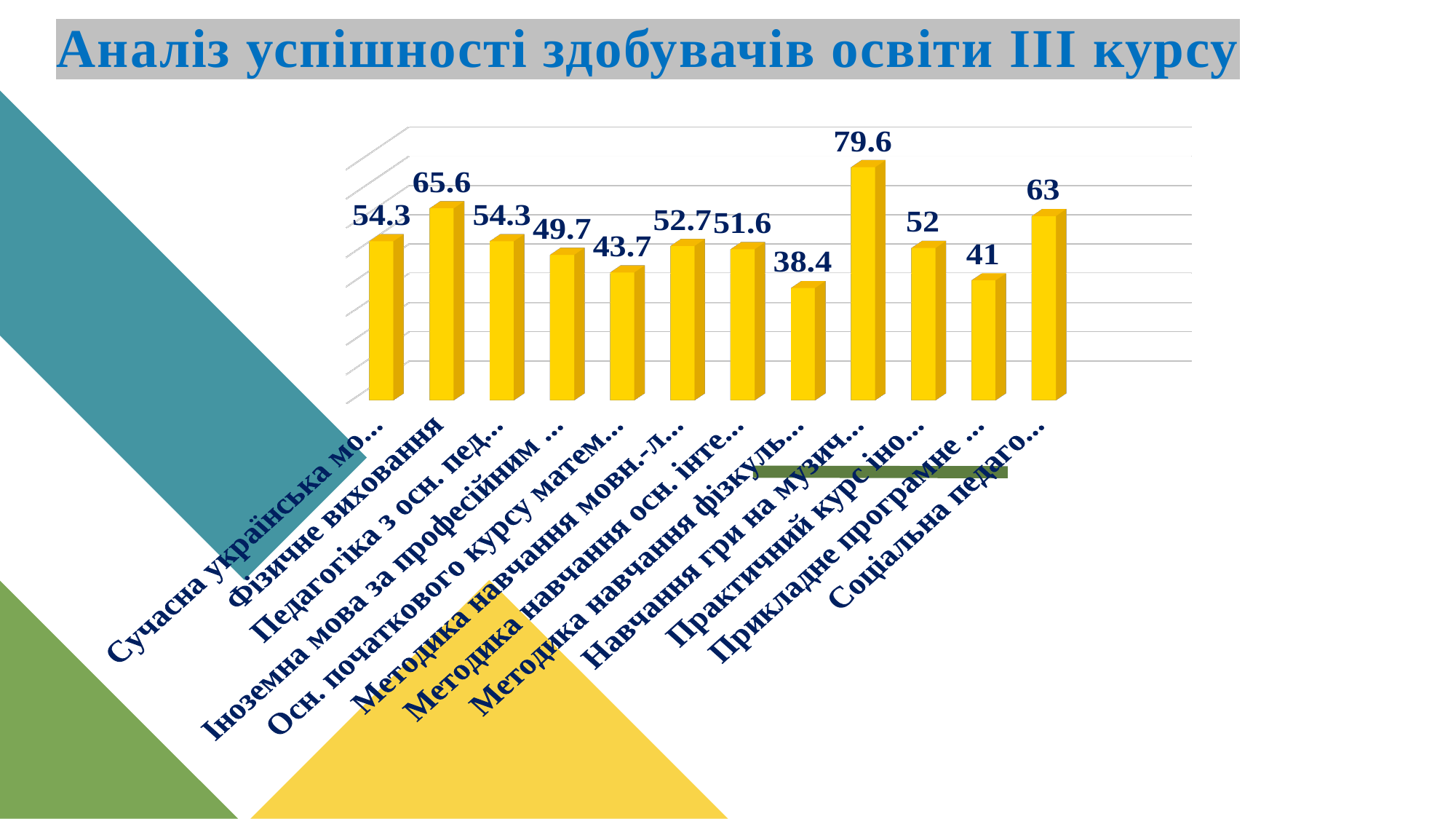
Which category has the highest value? Навчання гри на музич... What value is shown for the bar labelled "Навчання гри на музич..."? 79.6 Which category has the lowest value? Методика навчання фізкуль... What value is shown for the bar labelled "Соціальна педаго..."? 63 What type of chart is shown on the slide? Bar chart What value is shown for the bar labelled "Прикладне програмне ..."? 41 How many bars are plotted in the chart? 12 What value is shown for the bar labelled "Практичний курс іно..."? 52 What is the difference between the values for Фізичне виховання and "Соціальна педаго..."? 2.6 What value is shown for Фізичне виховання? 65.6 Which is larger: the value for Фізичне виховання or the value for "Прикладне програмне ..."? Фізичне виховання What is the difference between the highest value (79.6) and the lowest value (38.4)? 41.2